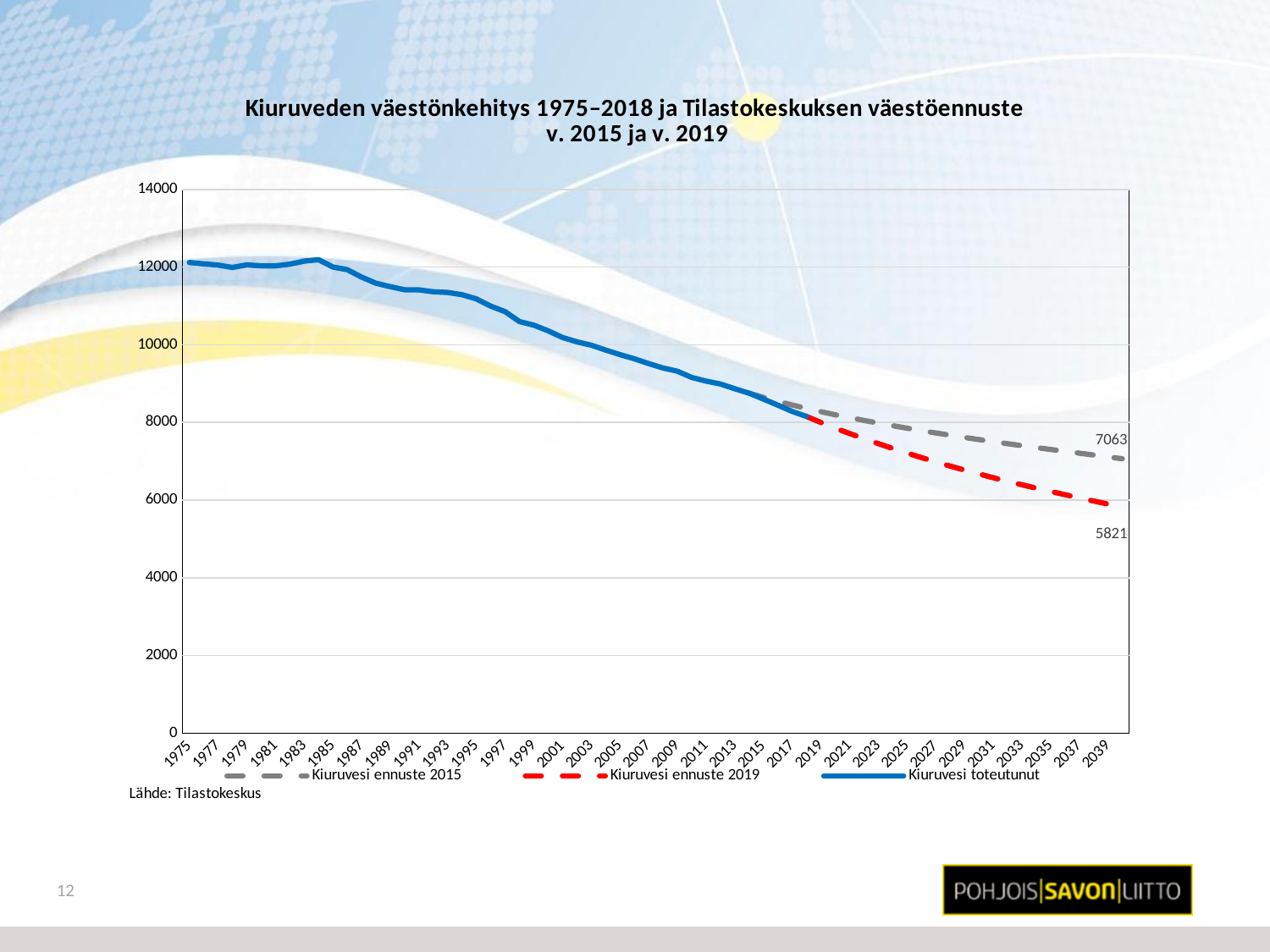
What is the title of the chart? Kiuruveden väestönkehitys 1975–2018 ja Tilastokeskuksen väestöennuste v. 2015 ja v. 2019 Is the value for Kiuruvesi toteutunut in 2017 greater or less than 10000? less Does the Kiuruvesi toteutunut series rise or fall from 1975 to 2018? fall Which forecast series has the higher value in 2039, Kiuruvesi ennuste 2015 or Kiuruvesi ennuste 2019? Kiuruvesi ennuste 2015 Is the value for Kiuruvesi toteutunut in 1975 greater or less than 10000? greater What kind of chart is shown on the slide? line chart What colour is the Kiuruvesi toteutunut line? blue How many series does the legend list? 3